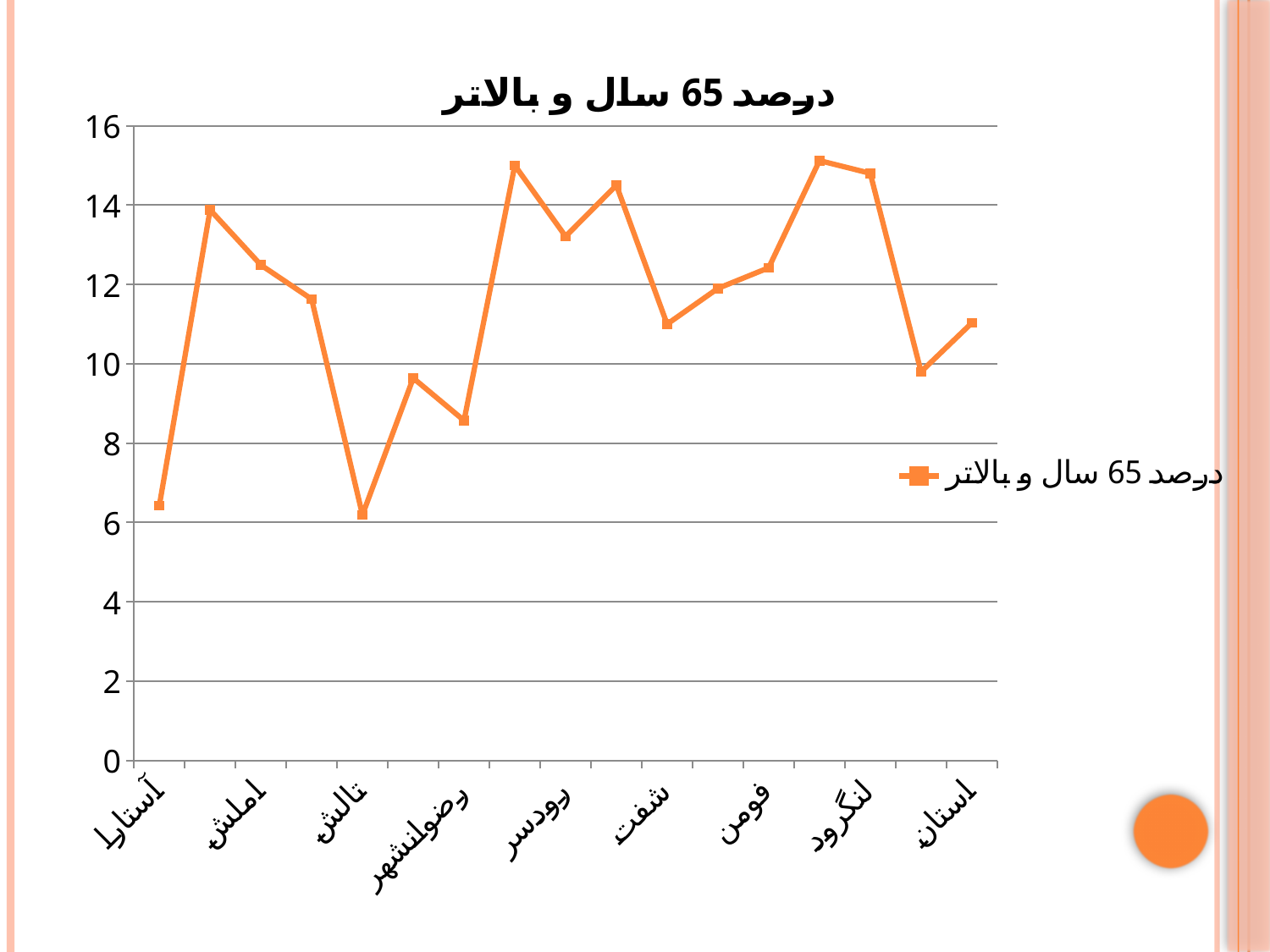
Which has the larger value, لنگرود or آستارا? لنگرود Is the value for تالش greater or less than 8? less Is the value for رودسر greater or less than 12? greater Is the value for رضوانشهر greater or less than 10? less How many series does the legend list? 1 What is the title of the chart? درصد 65 سال و بالاتر How many data points are plotted on the line? 17 Which has the larger value, رودسر or رضوانشهر? رودسر What kind of chart is shown on the slide? line chart